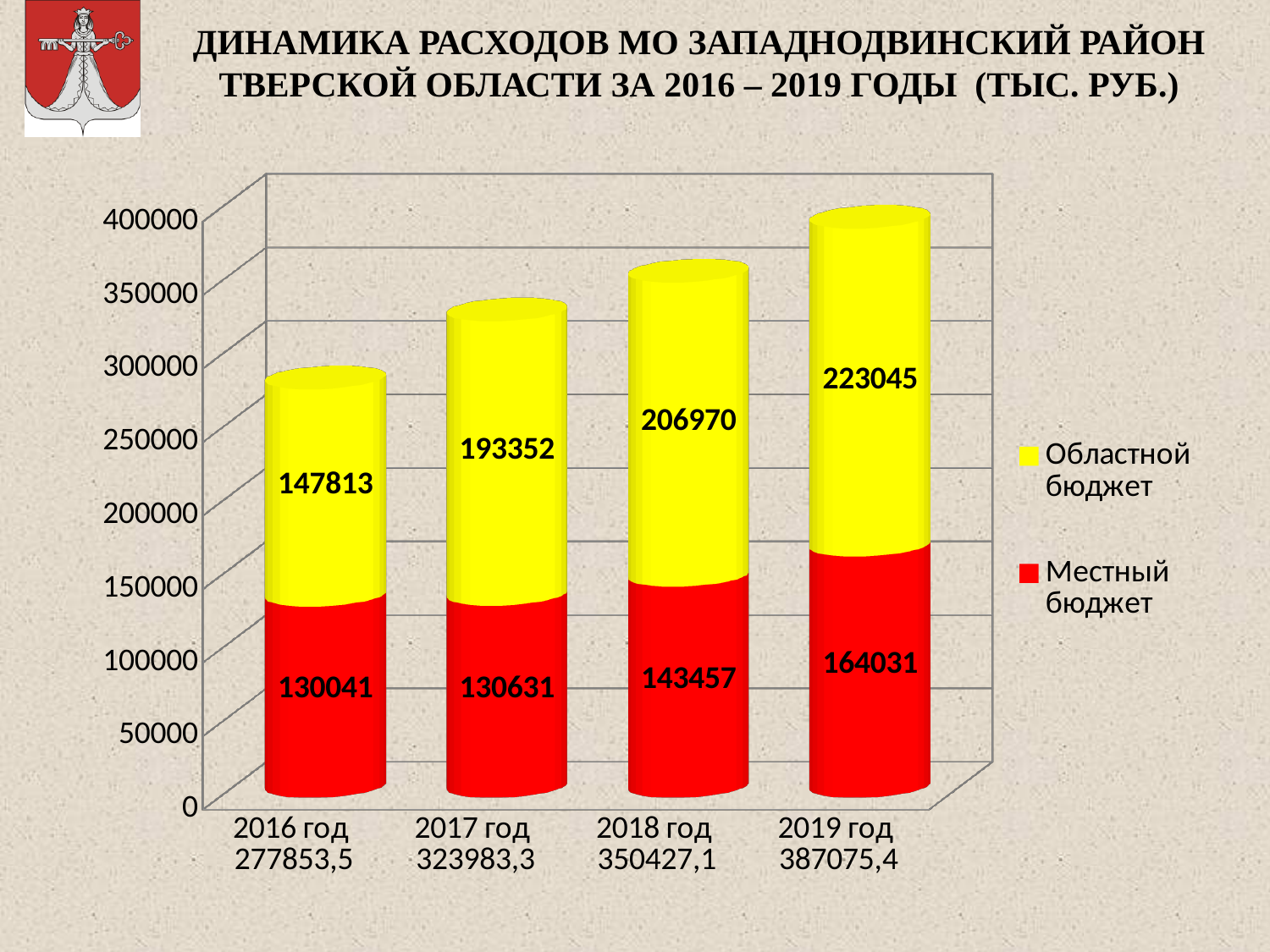
In which year is Областной бюджет the lowest? 2016 год What is the difference between Областной бюджет in 2019 год and in 2016 год? 75232 Do the total expenditures rise or fall from 2016 to 2019? Rise Which is larger in 2017 год: Областной бюджет or Местный бюджет? Областной бюджет What total expenditure is printed under the 2019 год label? 387075,4 How many years (categories) are shown on the x axis? 4 What is the value of Областной бюджет for 2016 год? 147813 What is the value of Областной бюджет for 2019 год? 223045 In which year is Местный бюджет the highest? 2019 год What is the value of Местный бюджет for 2018 год? 143457 How many series does the legend list? 2 What kind of chart is shown on the slide? Stacked bar chart